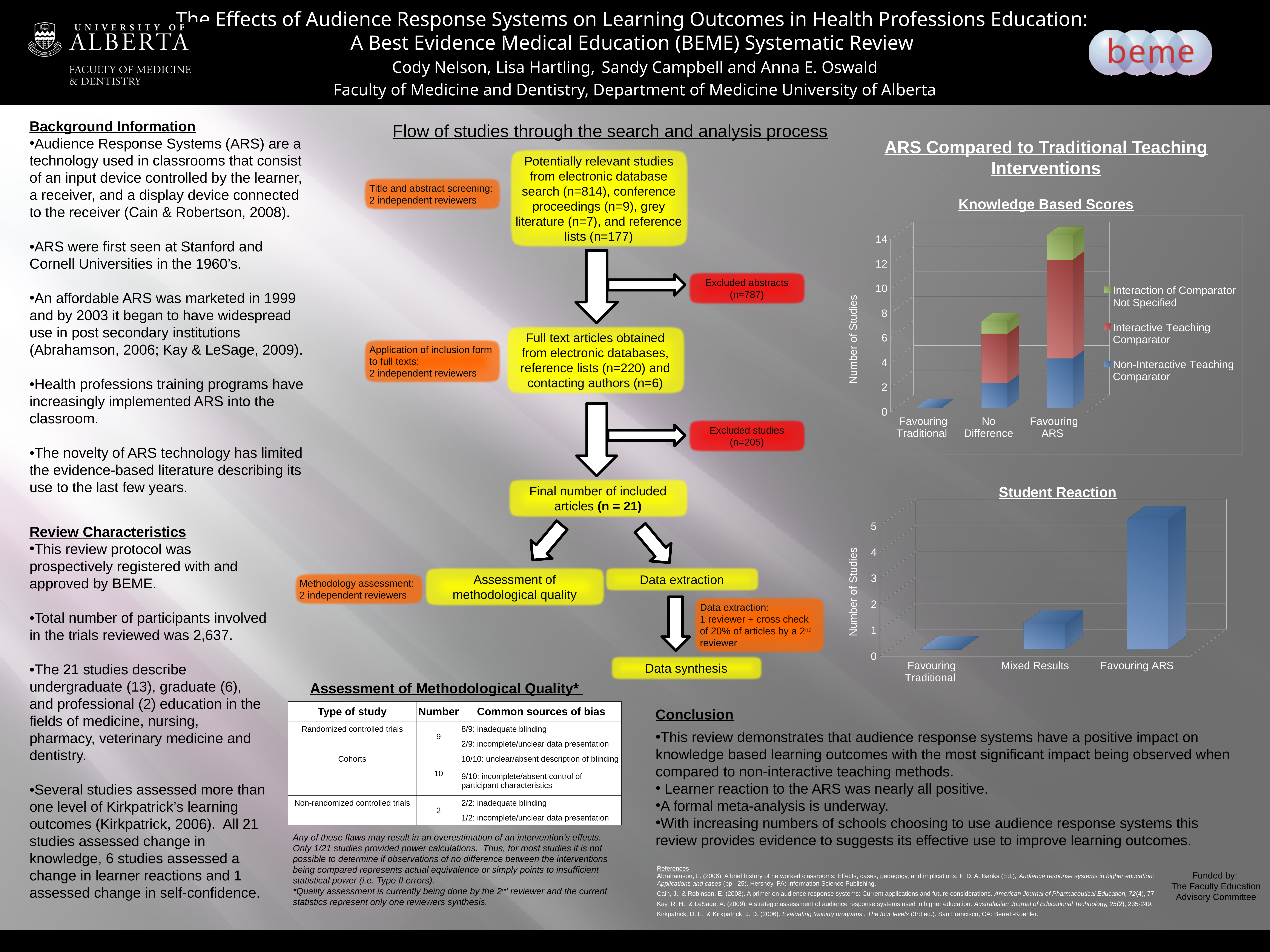
In the Student Reaction chart, is the value for Mixed Results greater or less than 3? less How many series does the legend of the Knowledge Based Scores chart list? 3 In the Knowledge Based Scores chart, is the total number of studies for No Difference greater or less than 10? less What is the y-axis title of the Knowledge Based Scores chart? Number of Studies In the Knowledge Based Scores chart, which category has the lowest total number of studies? Favouring Traditional In the Knowledge Based Scores chart, which has more studies in total: No Difference or Favouring ARS? Favouring ARS In the Student Reaction chart, which category has the highest number of studies? Favouring ARS What kind of chart is the Knowledge Based Scores chart? bar chart In the Knowledge Based Scores chart, is the total number of studies for Favouring ARS greater or less than 10? greater In the Knowledge Based Scores chart, which category has the highest total number of studies? Favouring ARS What kind of chart is the Student Reaction chart? bar chart How many categories are shown on the x axis of the Knowledge Based Scores chart? 3